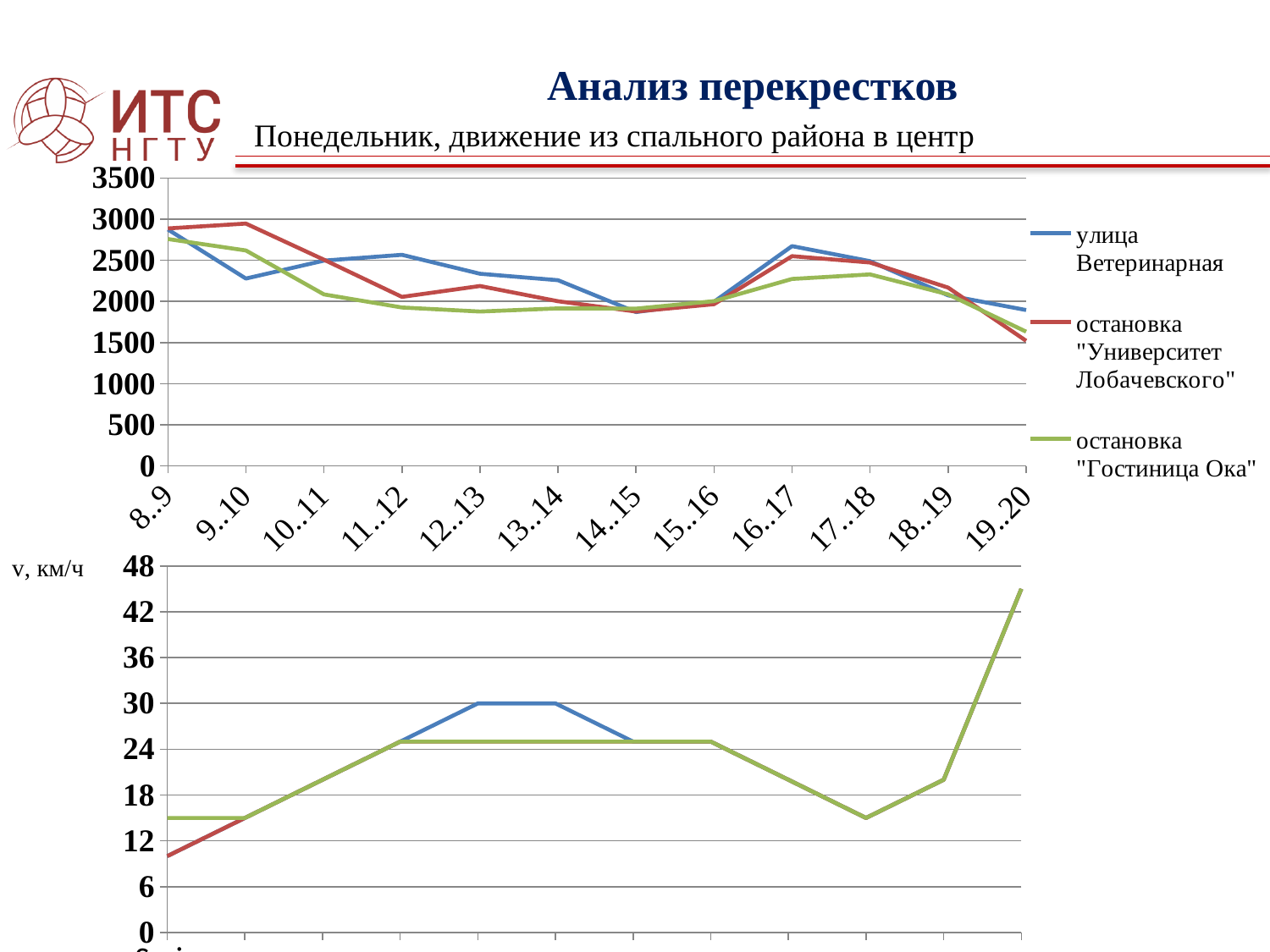
On the top chart, how many time intervals are shown on the x axis? 12 What is the y-axis label of the bottom chart? v, км/ч On the top chart, is the value for улица Ветеринарная at 9..10 greater or less than 2500? less On the top chart, which series has the highest value at 11..12? улица Ветеринарная On the top chart, is the value for остановка "Гостиница Ока" at 12..13 greater or less than 2000? less On the top chart, how many series does the legend list? 3 On the top chart, is the value for улица Ветеринарная at 16..17 greater or less than 2500? greater On the top chart, does the value for улица Ветеринарная rise or fall from 16..17 to 19..20? fall What kind of chart is the top chart? line chart On the top chart, which series has the highest value at 9..10? остановка "Университет Лобачевского" On the top chart, which series has the lowest value at 9..10? улица Ветеринарная On the top chart, which series has the lowest value at 19..20? остановка "Университет Лобачевского"